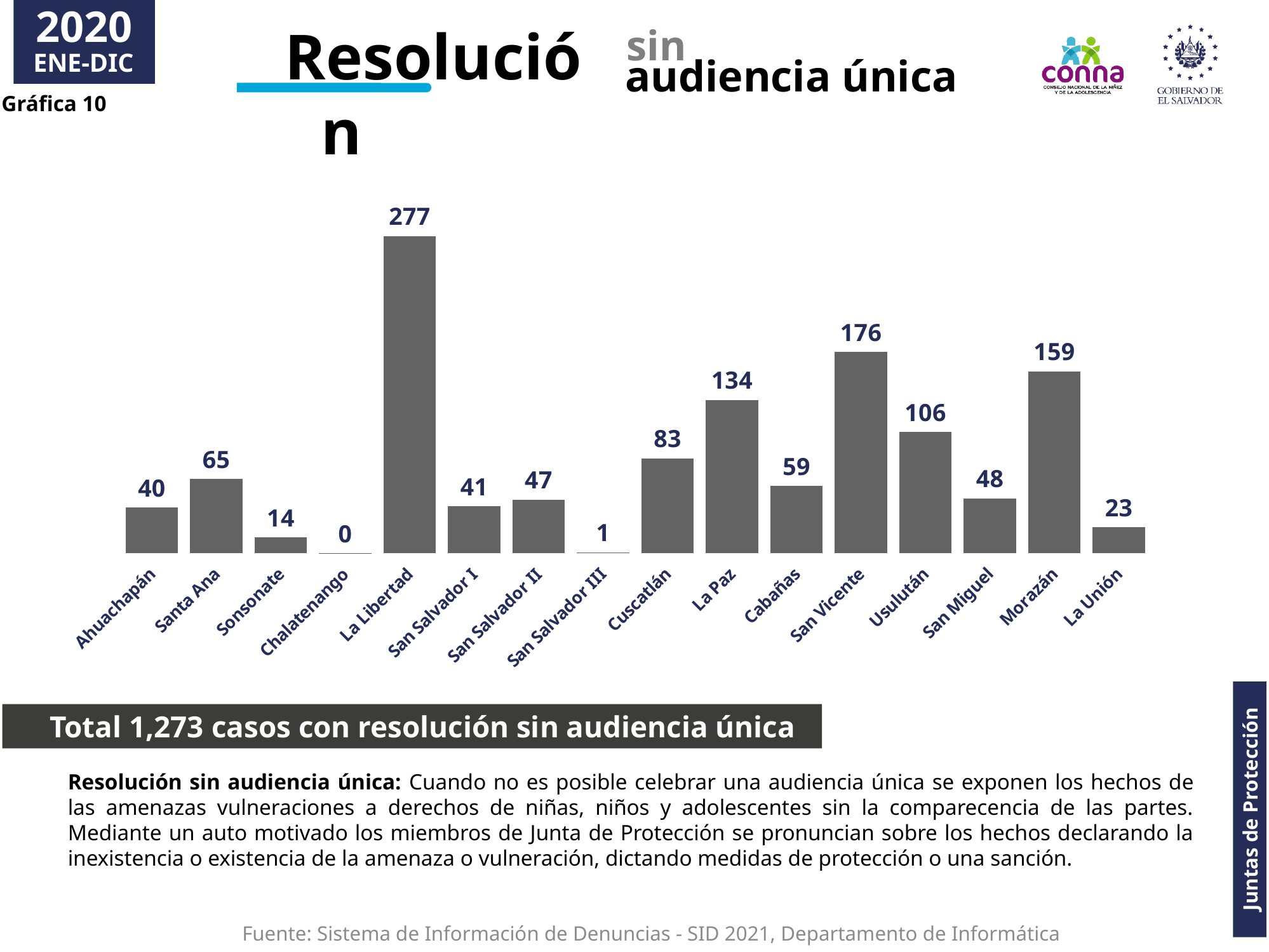
What is the value for San Vicente? 176 How many categories are shown on the x axis? 16 Which category has the lowest value? Chalatenango What kind of chart is shown on the slide? Bar chart What is the value for San Salvador III? 1 What is the value for Chalatenango? 0 What total number of cases does the slide state below the chart? 1,273 Which category has the highest value? La Libertad What is the difference between the values for Morazán and Usulután? 53 What is the difference between the values for Santa Ana and Ahuachapán? 25 Which is larger, the value for La Paz or the value for Cuscatlán? La Paz What is the value for La Libertad? 277